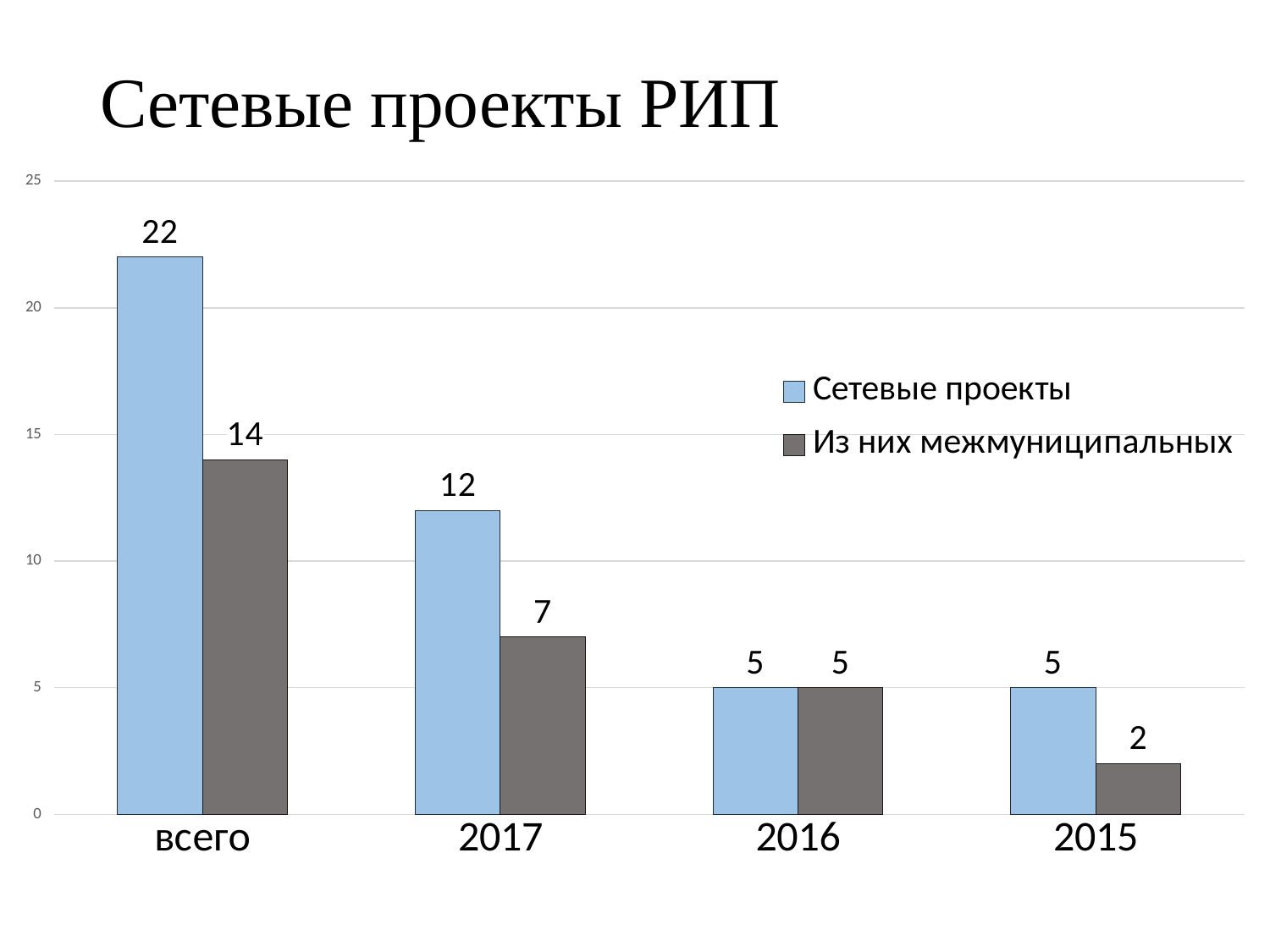
What is the title of the slide? Сетевые проекты РИП How many series does the legend list? 2 What is the value of Из них межмуниципальных for 2015? 2 What is the difference between Сетевые проекты and Из них межмуниципальных for 2017? 5 What is the value of Сетевые проекты for всего? 22 What kind of chart is shown on the slide? bar chart What is the value of Из них межмуниципальных for 2017? 7 Which is larger for всего: Сетевые проекты or Из них межмуниципальных? Сетевые проекты Which category has the highest value for Сетевые проекты? всего Is the value of Сетевые проекты for всего greater or less than 20? greater How many categories are shown on the x axis? 4 Which category has the lowest value for Из них межмуниципальных? 2015